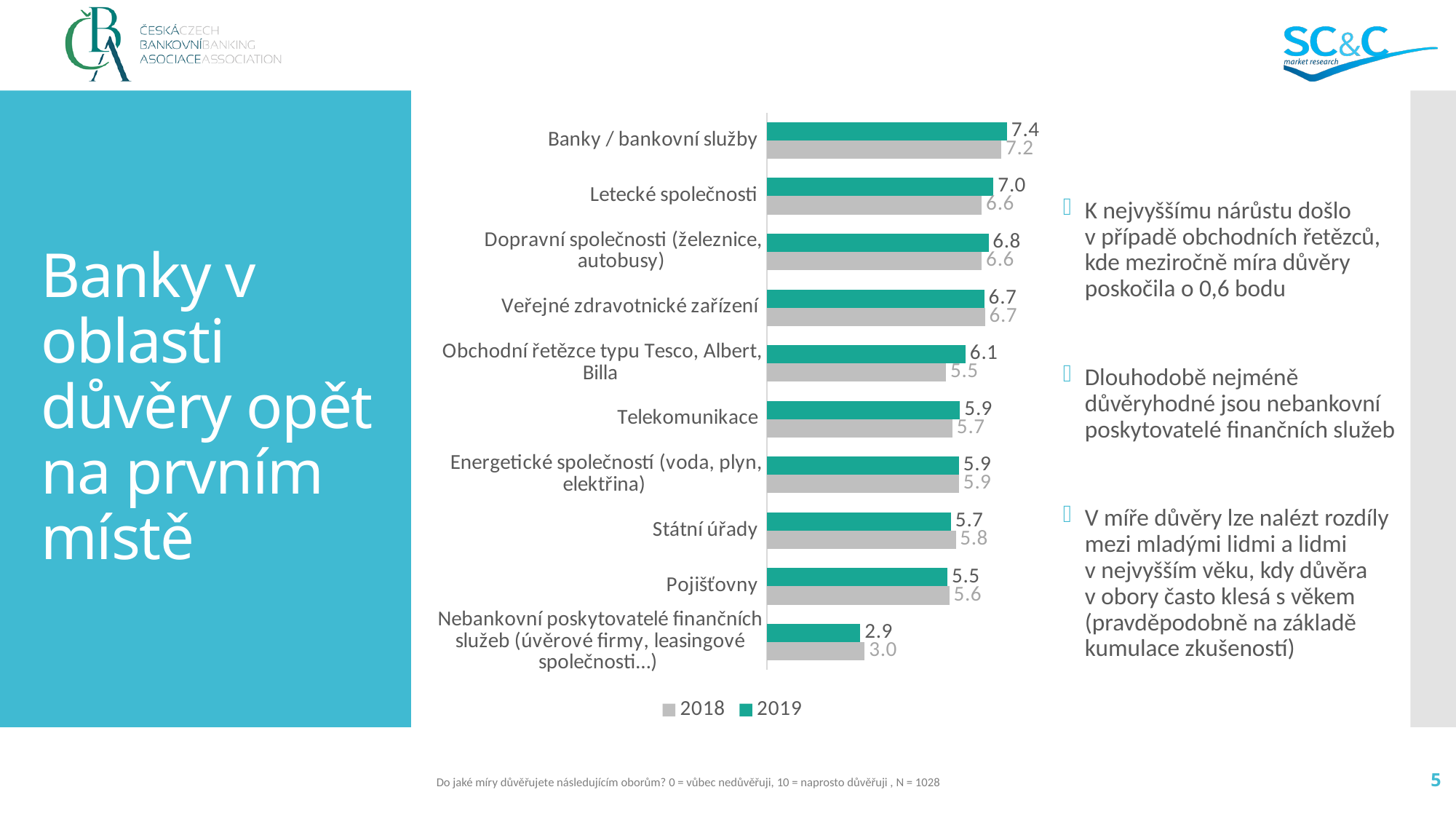
Is the 2019 value for Telekomunikace greater or less than the 2019 value for Pojišťovny? greater Which category has the lowest 2018 value? Nebankovní poskytovatelé finančních služeb (úvěrové firmy, leasingové společnosti…) How many categories are shown in the chart? 10 How many series does the legend list? 2 What kind of chart is shown on the slide? Bar chart Which category has the highest 2019 value? Banky / bankovní služby Which is larger for Státní úřady, the 2018 value or the 2019 value? 2018 What is the 2019 value for Obchodní řetězce typu Tesco, Albert, Billa? 6.1 Which colour represents the 2019 series in the chart? Teal (green) What is the 2019 value for Banky / bankovní služby? 7.4 What is the difference between the 2019 and 2018 values for Obchodní řetězce typu Tesco, Albert, Billa? 0.6 What is the 2018 value for Letecké společnosti? 6.6